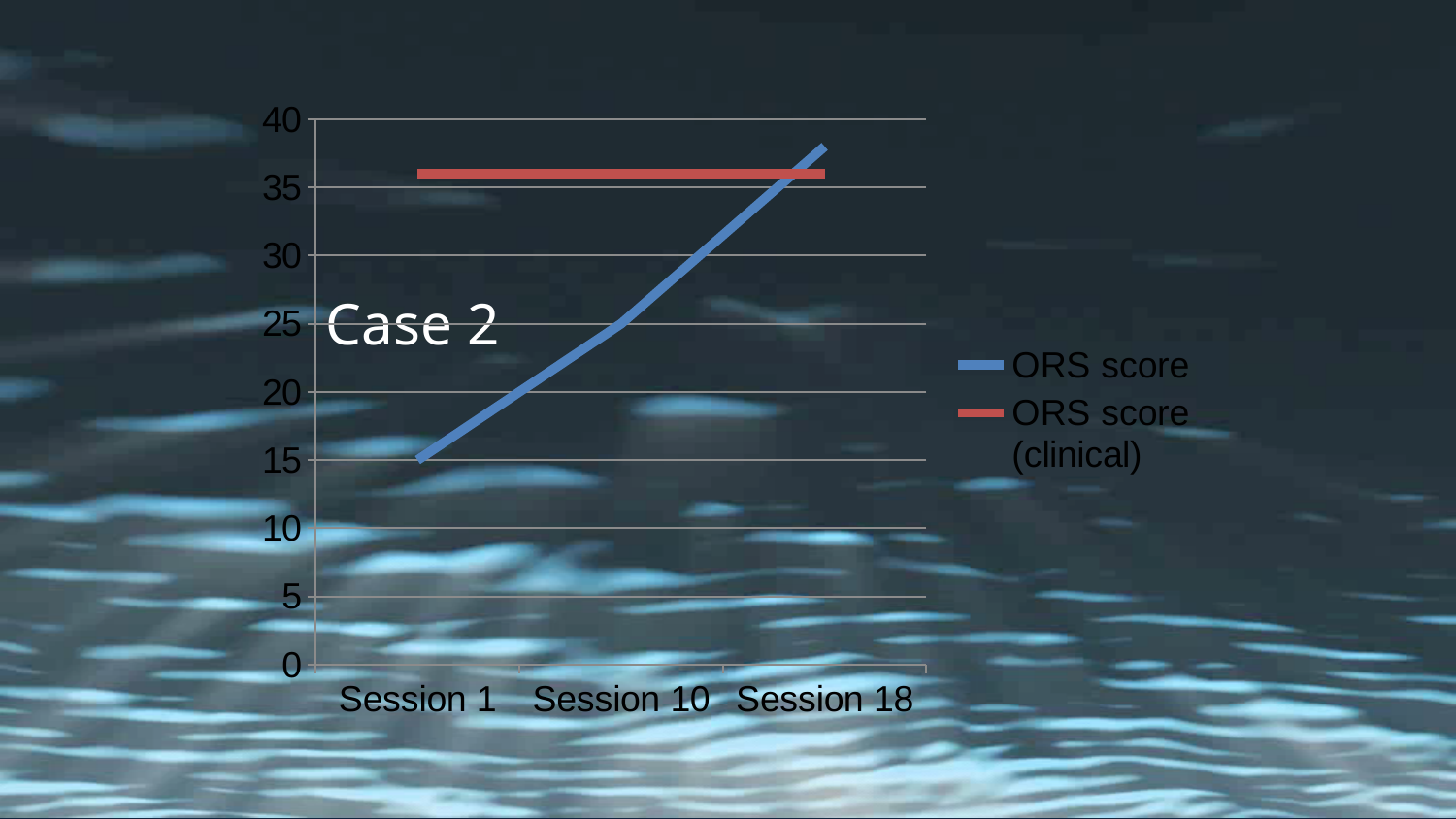
What is the difference between the ORS score at Session 10 and at Session 1? 10 Does the ORS score rise or fall from Session 1 to Session 18? rise At Session 1, which is larger: the ORS score or the ORS score (clinical)? ORS score (clinical) What is the ORS score at Session 10? 25 What kind of chart is shown on the slide? line chart Is the ORS score at Session 18 greater or less than 35? greater How many sessions are shown along the x axis? 3 How many series does the legend list? 2 At which session is the ORS score highest? Session 18 What is the ORS score at Session 1? 15 Is the ORS score (clinical) line greater or less than 40? less At which session is the ORS score lowest? Session 1